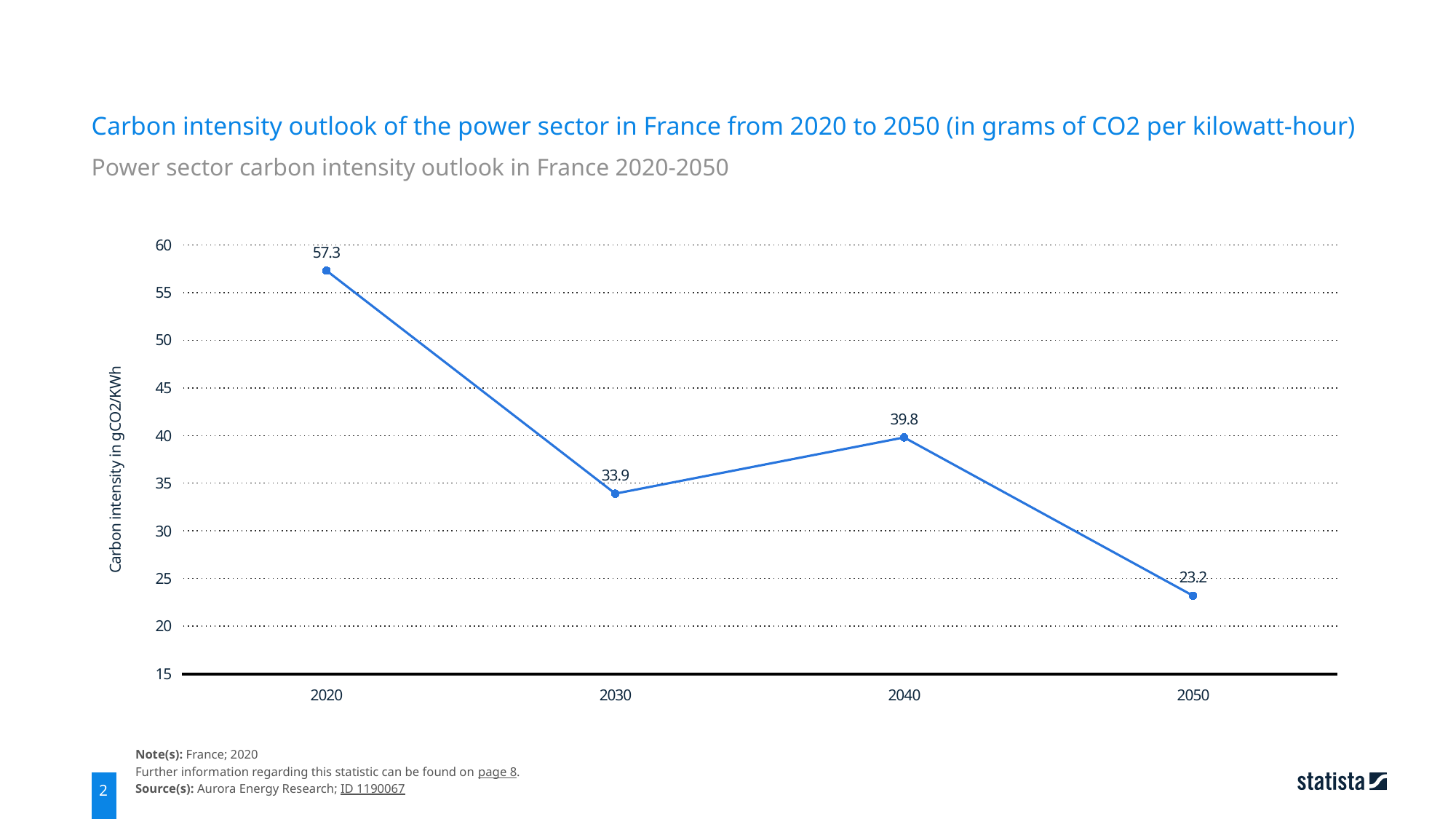
What is the carbon intensity value for 2020? 57.3 What is the carbon intensity value for 2040? 39.8 What is the carbon intensity value for 2050? 23.2 What is the difference between the carbon intensity in 2020 and in 2050? 34.1 What is the carbon intensity value for 2030? 33.9 Which year has the lowest carbon intensity? 2050 Is the value for 2040 greater or less than 35? greater How many data points are plotted on the chart? 4 What is the label of the y axis? Carbon intensity in gCO2/KWh Which year has a higher carbon intensity, 2030 or 2040? 2040 Which year has the highest carbon intensity? 2020 What kind of chart is shown on the slide? Line chart